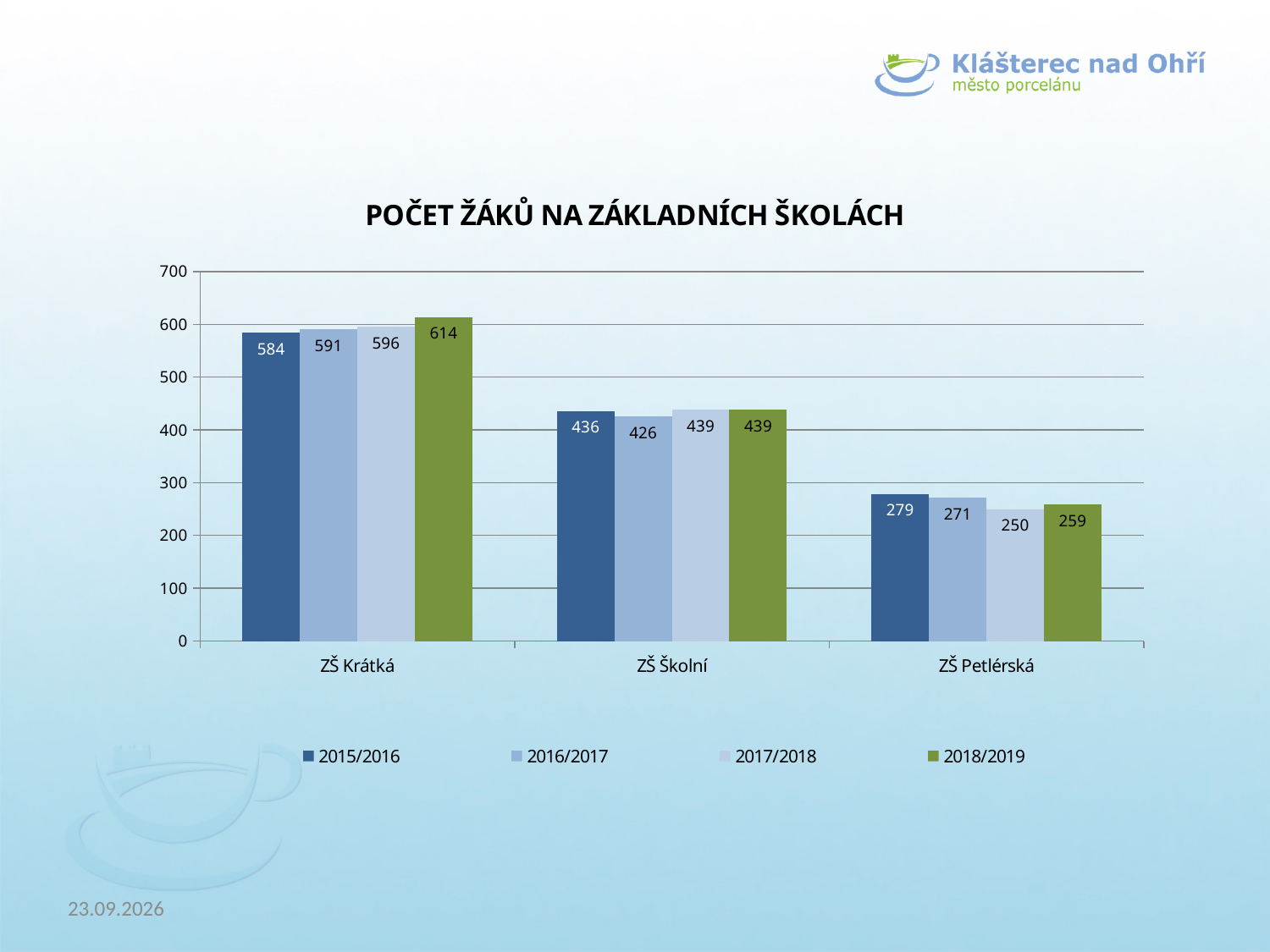
Which school has the highest value in the 2015/2016 series? ZŠ Krátká What is the title of the chart? POČET ŽÁKŮ NA ZÁKLADNÍCH ŠKOLÁCH What is the value for ZŠ Krátká in the 2018/2019 series? 614 What is the difference between the 2018/2019 and 2015/2016 values for ZŠ Krátká? 30 What is the value for ZŠ Petlérská in the 2017/2018 series? 250 Which is larger for ZŠ Petlérská: the 2015/2016 value or the 2018/2019 value? 2015/2016 What is the value for ZŠ Školní in the 2016/2017 series? 426 Which school has the lowest value in the 2018/2019 series? ZŠ Petlérská How many series does the legend list? 4 What kind of chart is shown on the slide? bar chart How many schools are shown on the x axis? 3 Is the value for ZŠ Školní in 2018/2019 greater or less than 500? less